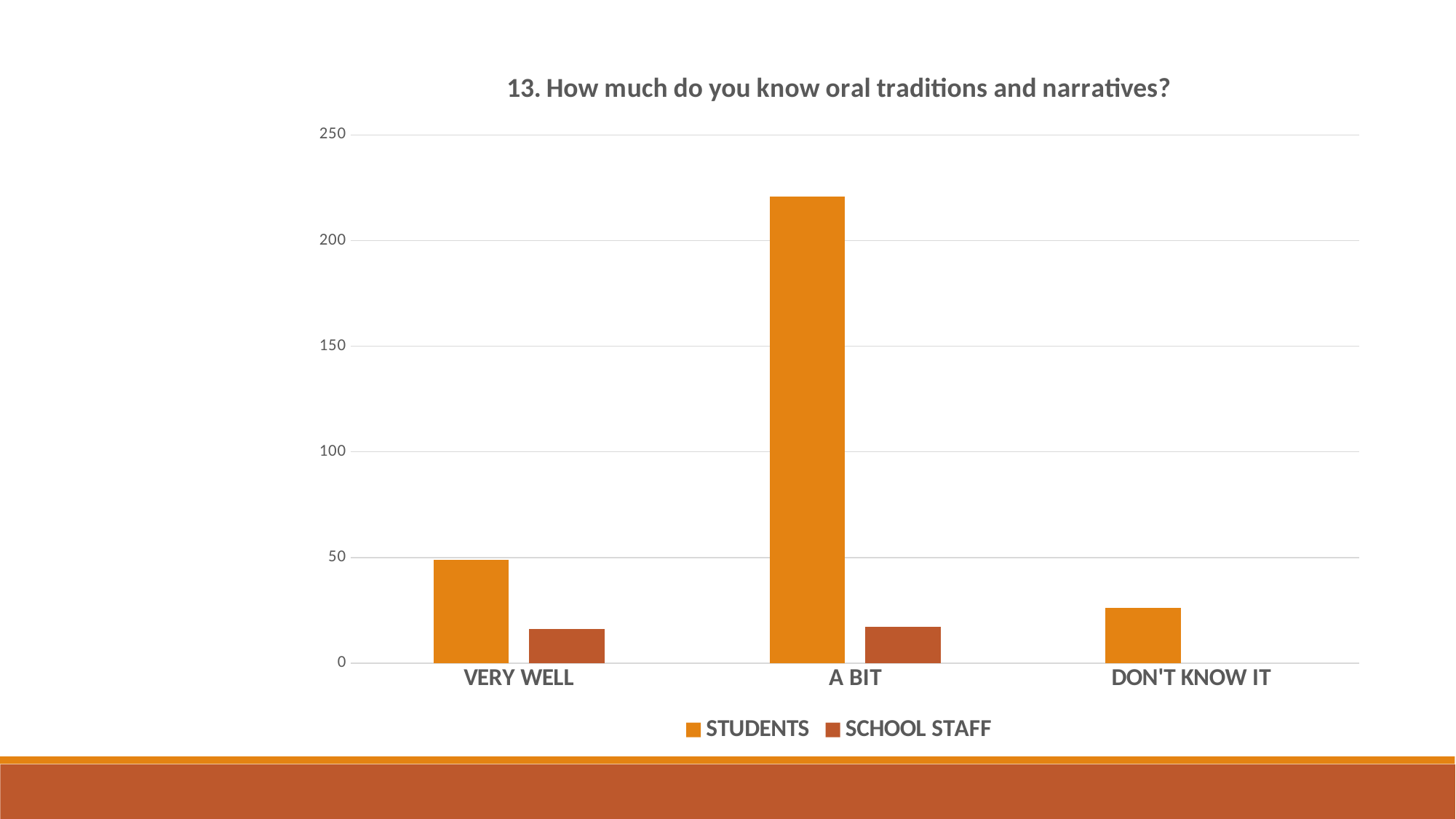
Is the SCHOOL STAFF value for A BIT greater or less than 50? less How many categories are shown on the x axis? 3 What is the title of the chart? 13. How much do you know oral traditions and narratives? Which category has the lowest value for STUDENTS? DON'T KNOW IT For VERY WELL, which series has the larger value, STUDENTS or SCHOOL STAFF? STUDENTS How many series does the legend list? 2 Which category has the highest value for STUDENTS? A BIT What kind of chart is shown on the slide? bar chart Which series is shown in the darker brown colour? SCHOOL STAFF Is the STUDENTS value for A BIT greater or less than 200? greater Is the STUDENTS value for DON'T KNOW IT greater or less than 50? less